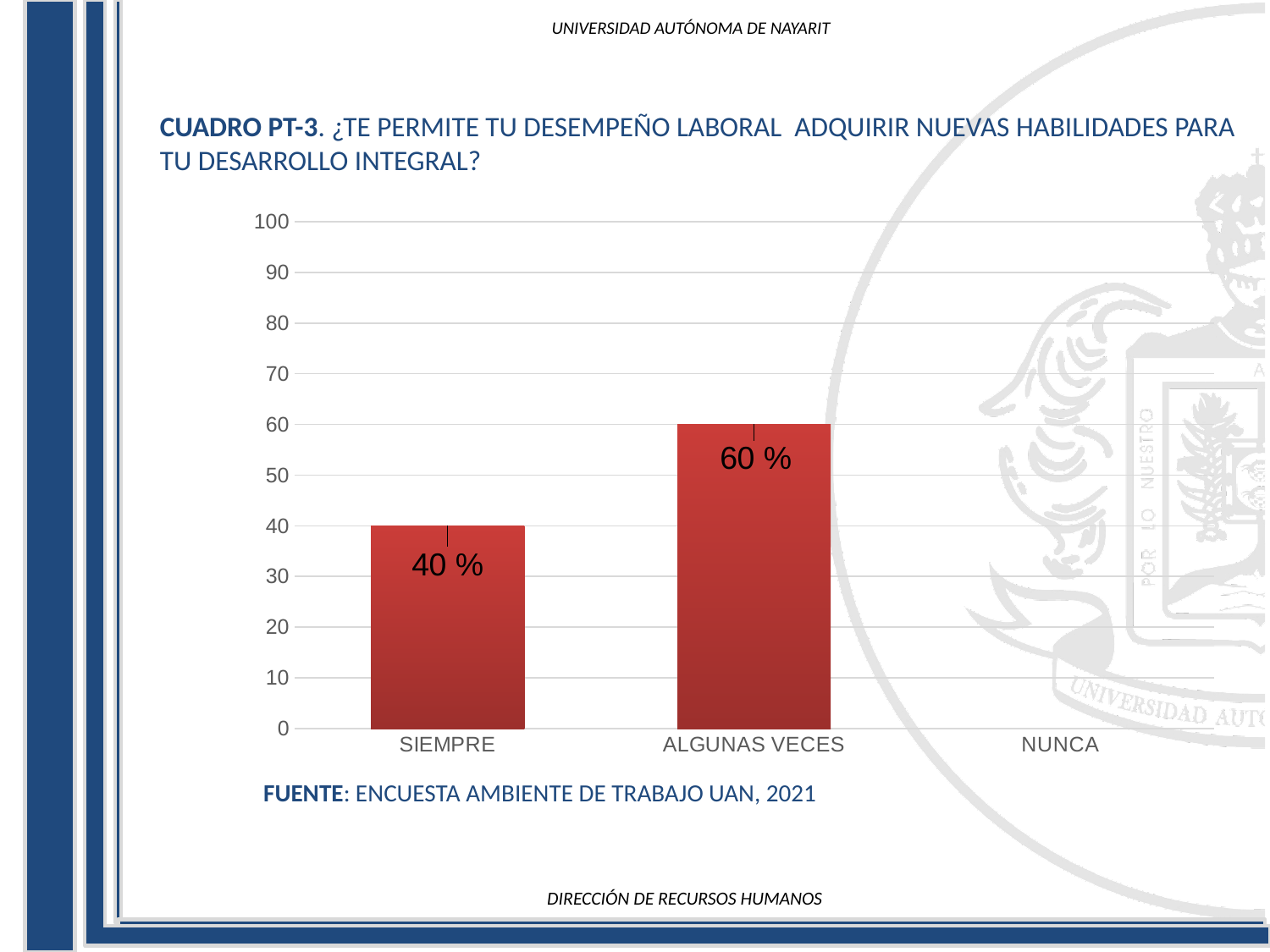
Which category has the highest value? ALGUNAS VECES What is the value for SIEMPRE? 40 % Is the value for ALGUNAS VECES greater or less than 50? greater What is the value for ALGUNAS VECES? 60 % What kind of chart is shown on the slide? bar chart Is the value for SIEMPRE greater or less than 50? less What source is cited below the chart? ENCUESTA AMBIENTE DE TRABAJO UAN, 2021 Which is larger, the value for SIEMPRE or the value for ALGUNAS VECES? ALGUNAS VECES What is the difference between the values for ALGUNAS VECES and SIEMPRE? 20 % What is the highest value shown on the vertical axis? 100 How many categories are shown on the x axis? 3